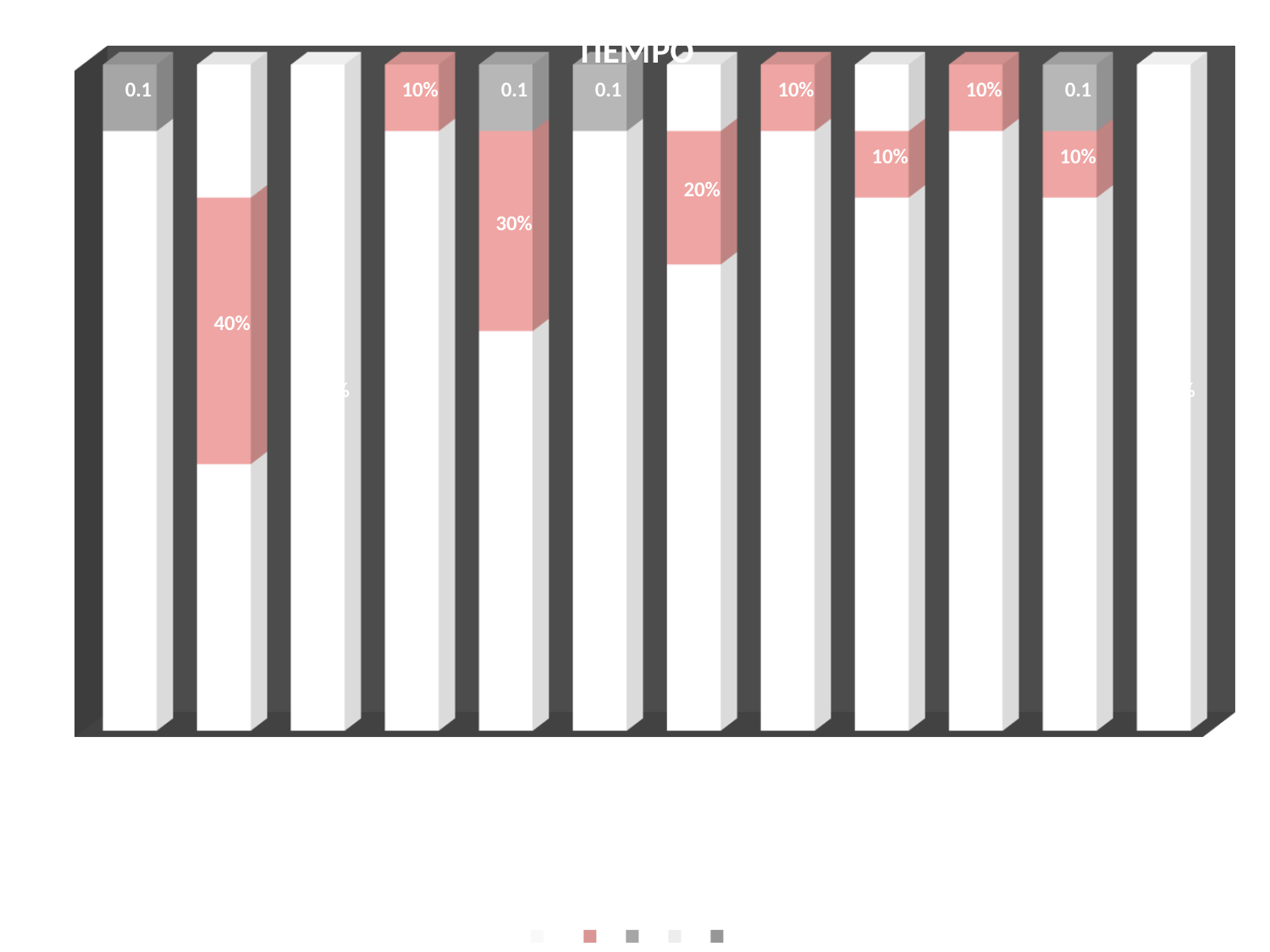
What kind of chart is shown on the slide? bar chart What is the difference between the pink segment of the second bar from the left (40%) and the pink segment of the seventh bar from the left (20%)? 20% How many bars are plotted in the chart? 12 How many series does the legend list? 5 Which bar has the largest labelled pink segment? the second bar from the left Which is larger: the pink segment of the second bar from the left or the pink segment of the fifth bar from the left? the second bar from the left What is the value printed on the pink segment of the fifth bar from the left? 30% What is the title of the chart? TIEMPO What is the difference between the pink segment of the second bar from the left (40%) and the pink segment of the fifth bar from the left (30%)? 10% What value is printed on the grey segment at the top of the first bar from the left? 0.1 What is the value printed on the pink segment of the seventh bar from the left? 20% What is the value printed on the pink segment of the second bar from the left? 40%